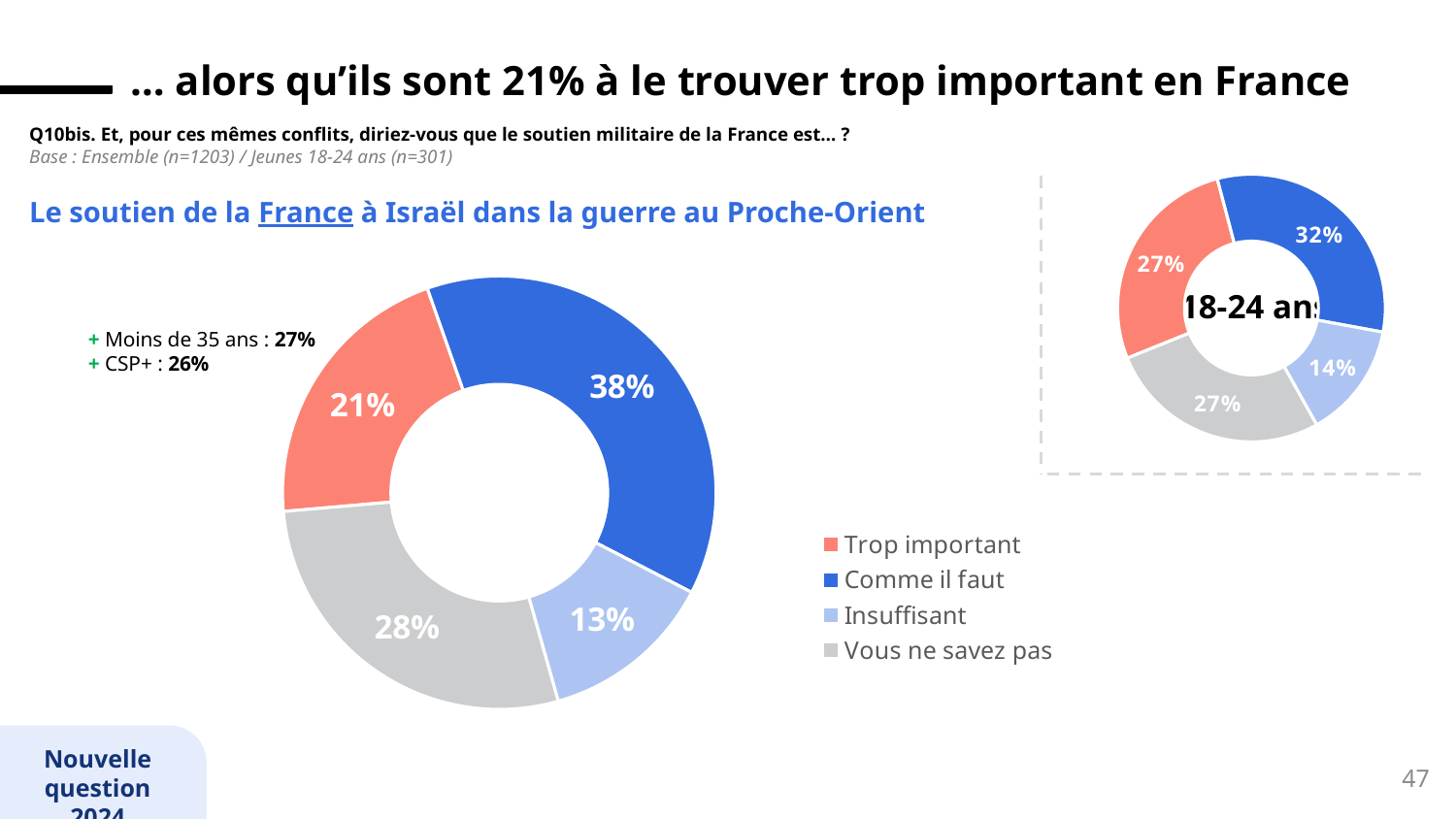
In the large donut chart on the left, what percentage corresponds to 'Comme il faut'? 38% How many categories does the legend list for the donut charts? 4 In the large donut chart on the left, what percentage corresponds to 'Trop important'? 21% In the small '18-24 ans' donut chart on the right, what percentage corresponds to 'Insuffisant'? 14% In the large donut chart on the left, which category has the smallest share? Insuffisant What type of chart is the large chart on the left? Donut (pie) chart Which is larger in the small '18-24 ans' donut chart: 'Comme il faut' or 'Trop important'? Comme il faut In the large donut chart on the left, which category has the largest share? Comme il faut In the small '18-24 ans' donut chart on the right, what percentage corresponds to 'Comme il faut'? 32% In the large donut chart on the left, what percentage corresponds to 'Vous ne savez pas'? 28% In the large donut chart on the left, what percentage corresponds to 'Insuffisant'? 13% In the large donut chart on the left, what is the difference between the 'Comme il faut' share and the 'Trop important' share? 17 percentage points